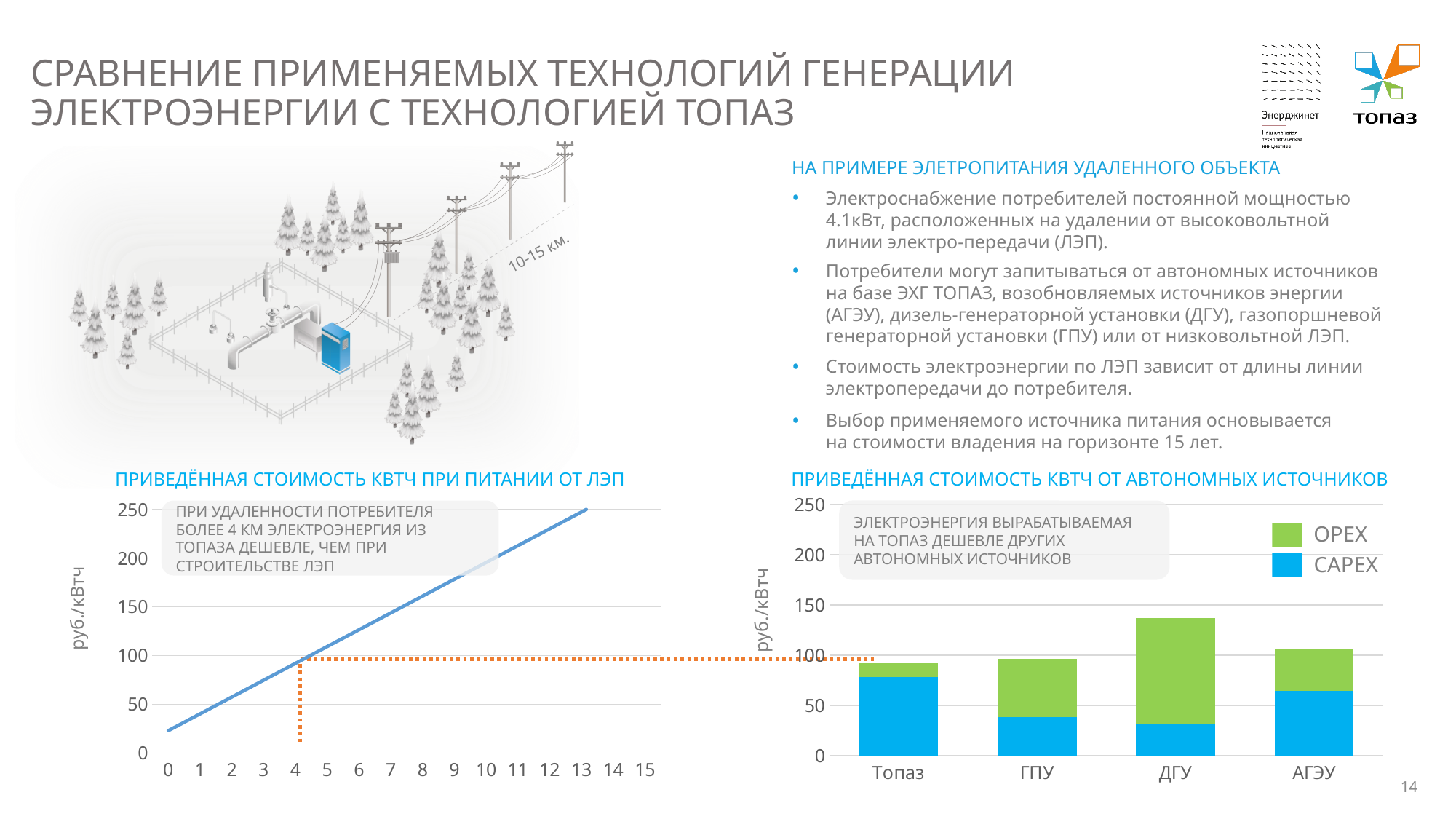
How many categories are shown on the x axis of the right chart 'ПРИВЕДЁННАЯ СТОИМОСТЬ КВТЧ ОТ АВТОНОМНЫХ ИСТОЧНИКОВ'? 4 In the left chart 'ПРИВЕДЁННАЯ СТОИМОСТЬ КВТЧ ПРИ ПИТАНИИ ОТ ЛЭП', is the value at x = 0 greater or less than 50? less How many series does the legend of the right chart 'ПРИВЕДЁННАЯ СТОИМОСТЬ КВТЧ ОТ АВТОНОМНЫХ ИСТОЧНИКОВ' list? 2 What kind of chart is the right chart titled 'ПРИВЕДЁННАЯ СТОИМОСТЬ КВТЧ ОТ АВТОНОМНЫХ ИСТОЧНИКОВ'? stacked bar chart In the right chart 'ПРИВЕДЁННАЯ СТОИМОСТЬ КВТЧ ОТ АВТОНОМНЫХ ИСТОЧНИКОВ', is the total bar for ДГУ greater or less than 100? greater In the left chart 'ПРИВЕДЁННАЯ СТОИМОСТЬ КВТЧ ПРИ ПИТАНИИ ОТ ЛЭП', is the value at x = 12 greater or less than 200? greater In the left chart 'ПРИВЕДЁННАЯ СТОИМОСТЬ КВТЧ ПРИ ПИТАНИИ ОТ ЛЭП', does the value rise or fall as the x axis increases? rise In the right chart 'ПРИВЕДЁННАЯ СТОИМОСТЬ КВТЧ ОТ АВТОНОМНЫХ ИСТОЧНИКОВ', which category has the lowest OPEX value? Топаз In the right chart 'ПРИВЕДЁННАЯ СТОИМОСТЬ КВТЧ ОТ АВТОНОМНЫХ ИСТОЧНИКОВ', which category has the highest CAPEX value? Топаз In the right chart 'ПРИВЕДЁННАЯ СТОИМОСТЬ КВТЧ ОТ АВТОНОМНЫХ ИСТОЧНИКОВ', which category has the highest total bar? ДГУ In the right chart 'ПРИВЕДЁННАЯ СТОИМОСТЬ КВТЧ ОТ АВТОНОМНЫХ ИСТОЧНИКОВ', which colour represents CAPEX? blue What kind of chart is the left chart titled 'ПРИВЕДЁННАЯ СТОИМОСТЬ КВТЧ ПРИ ПИТАНИИ ОТ ЛЭП'? line chart